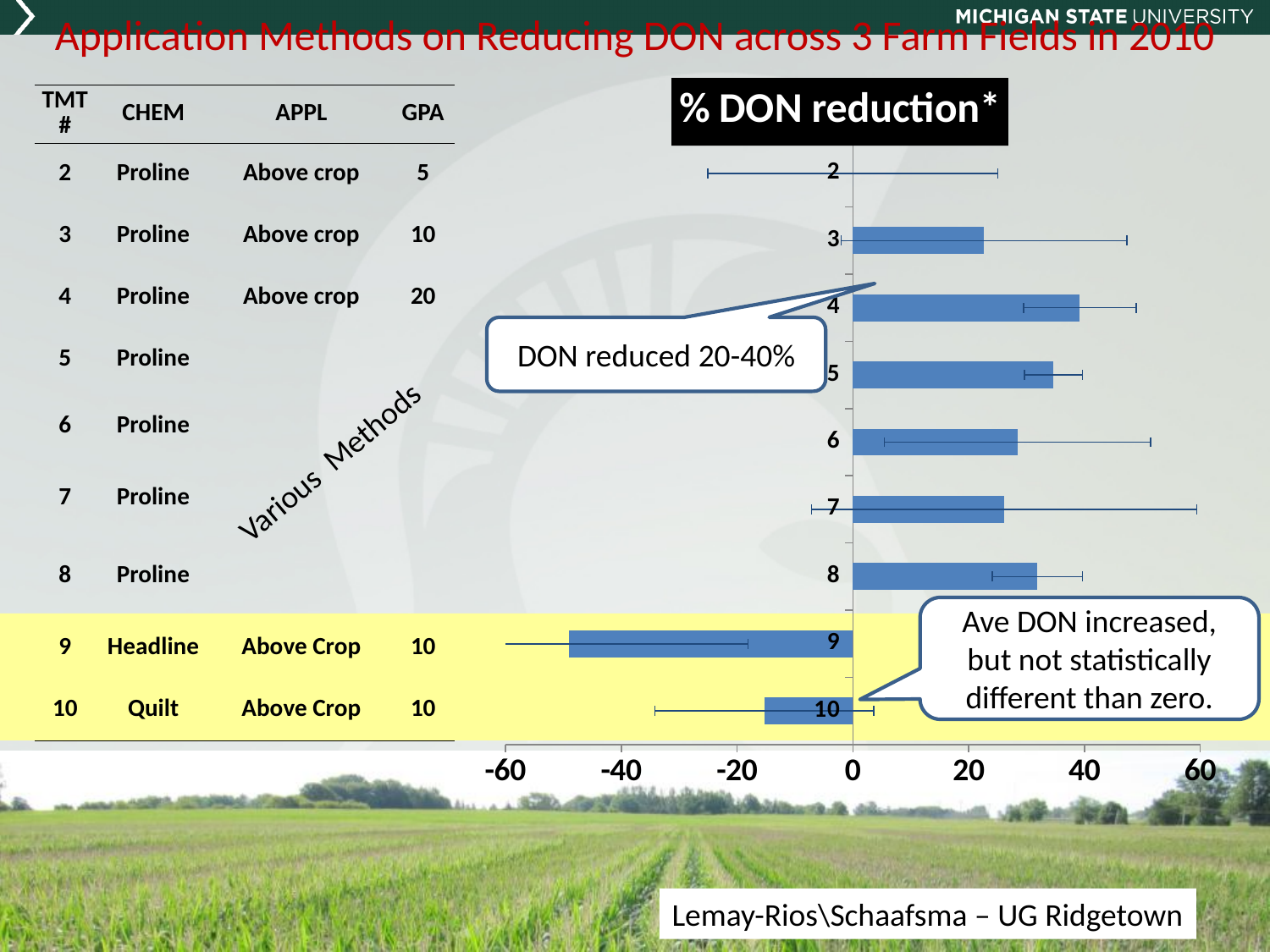
Which has the larger % DON reduction, treatment 8 or treatment 7? treatment 8 Is the value for treatment 4 greater or less than 20? greater Is the value for treatment 9 greater or less than -40? less Is the value for treatment 10 greater or less than 0? less How many treatment categories are plotted in the chart? 9 What is the title of the chart? % DON reduction* Which treatment number has the highest % DON reduction? 4 Which has the larger % DON reduction, treatment 4 or treatment 3? treatment 4 Which treatment number has the lowest % DON reduction? 9 What kind of chart is shown on the slide? bar chart